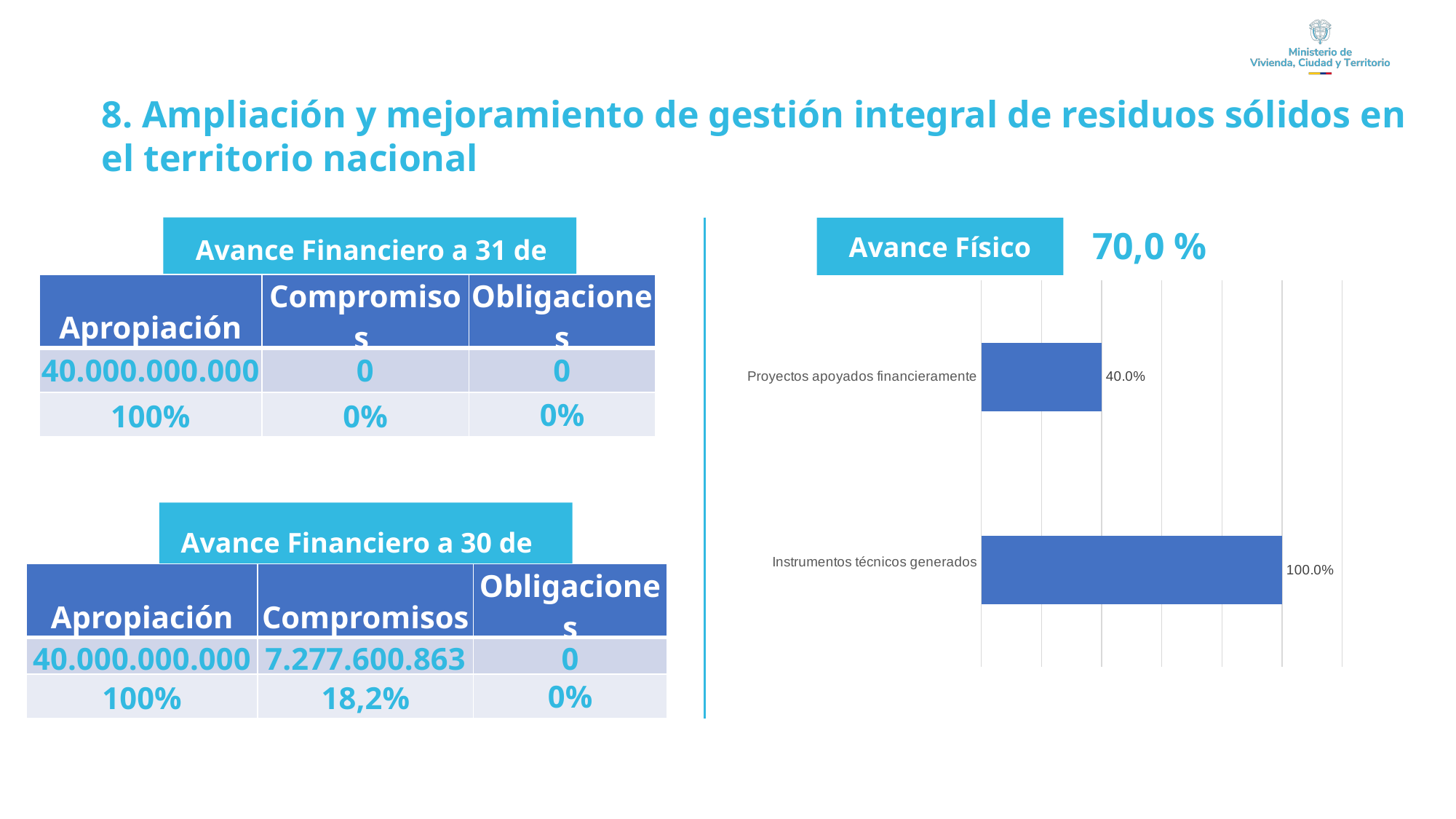
How many categories are plotted in the chart? 2 Which is larger: the value for Proyectos apoyados financieramente or the value for Instrumentos técnicos generados? Instrumentos técnicos generados What is the title shown above the chart? Avance Físico What value is shown for Proyectos apoyados financieramente in the chart? 40.0% Which category has the highest value in the chart? Instrumentos técnicos generados What value is shown for Instrumentos técnicos generados in the chart? 100.0% What is the difference between the values for Instrumentos técnicos generados and Proyectos apoyados financieramente? 60.0% Are the bars in the chart horizontal or vertical? Horizontal What kind of chart is shown on the slide? Bar chart Which category has the lowest value in the chart? Proyectos apoyados financieramente